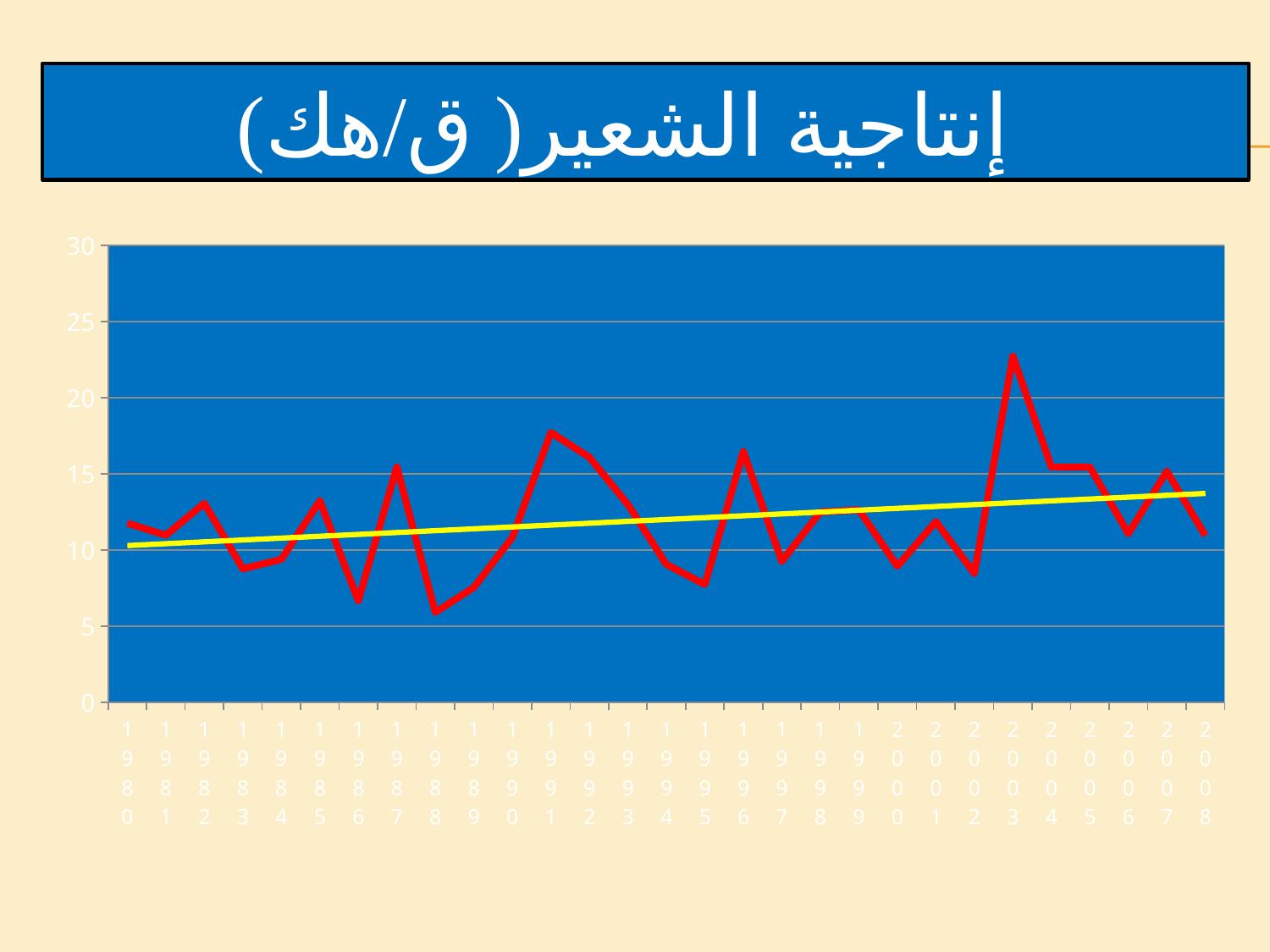
Is the value for 2000 greater or less than 10? less What is the highest value shown on the y axis? 30 Is the value for 1988 greater or less than 10? less Is the value for 1991 greater or less than 15? greater Which year has the highest barley productivity value? 2003 Which year has the larger value, 1983 or 1985? 1985 How many years are plotted along the x axis? 29 What kind of chart is shown on the slide? line chart Does the yellow trend line rise or fall from 1980 to 2008? rise Which year has the larger value, 1991 or 2003? 2003